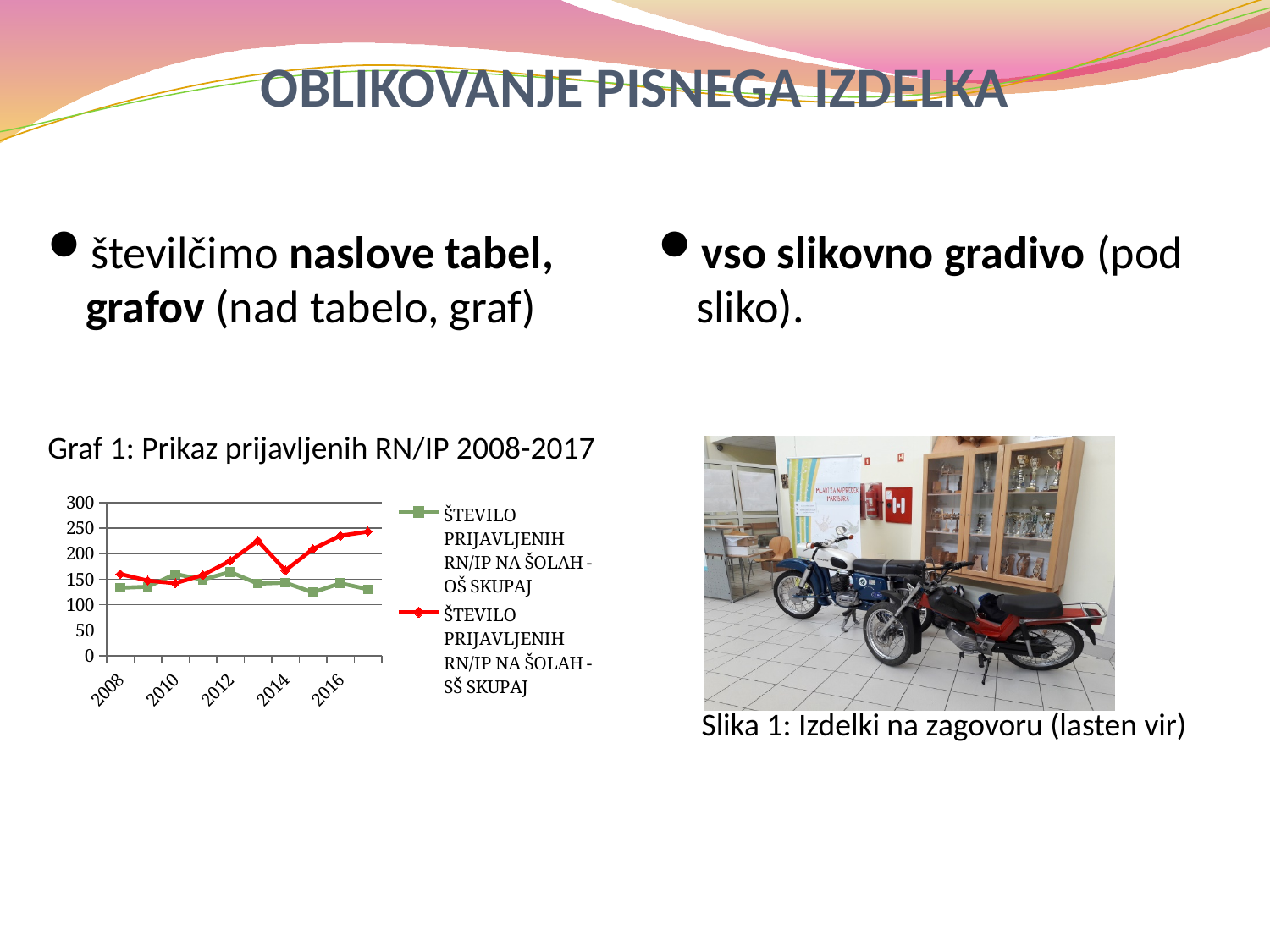
In Graf 1, is the value for ŠTEVILO PRIJAVLJENIH RN/IP NA ŠOLAH - OŠ SKUPAJ in 2015 greater or less than 150? less In Graf 1, is the value for ŠTEVILO PRIJAVLJENIH RN/IP NA ŠOLAH - SŠ SKUPAJ in 2017 greater or less than 200? greater How many series does the legend of Graf 1 list? 2 In Graf 1, which series has the larger value in 2017, OŠ SKUPAJ or SŠ SKUPAJ? SŠ SKUPAJ How many data points does each series in Graf 1 have? 10 What kind of chart is Graf 1 on the slide? line chart In Graf 1, what colour is the line for ŠTEVILO PRIJAVLJENIH RN/IP NA ŠOLAH - SŠ SKUPAJ? red In Graf 1, is the value for ŠTEVILO PRIJAVLJENIH RN/IP NA ŠOLAH - OŠ SKUPAJ in 2017 greater or less than 150? less In Graf 1, which series has the larger value in 2016, OŠ SKUPAJ or SŠ SKUPAJ? SŠ SKUPAJ In Graf 1, does the ŠTEVILO PRIJAVLJENIH RN/IP NA ŠOLAH - SŠ SKUPAJ series overall rise or fall from 2008 to 2017? rise What is the title of the chart on the slide? Graf 1: Prikaz prijavljenih RN/IP 2008-2017